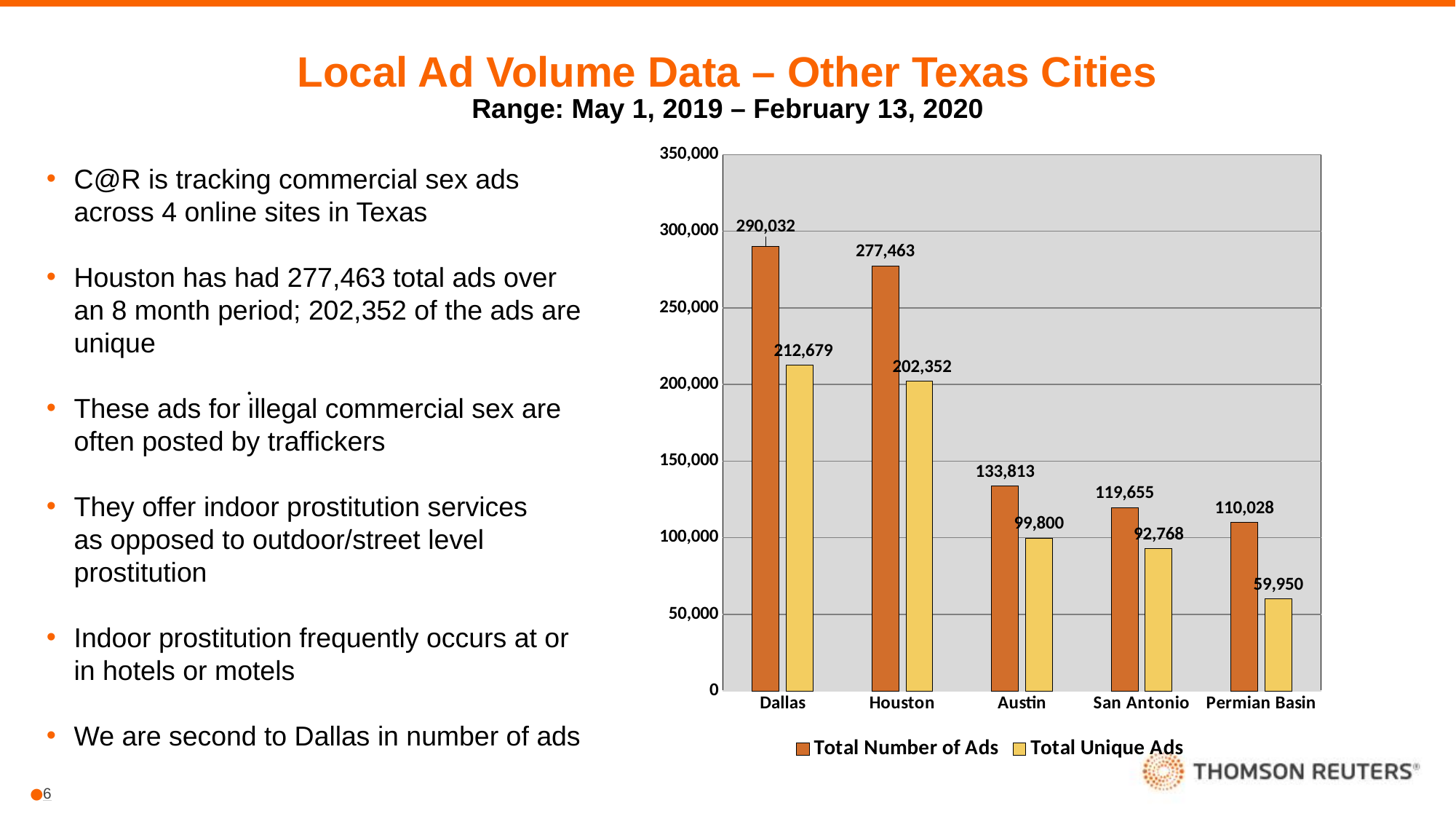
Is the Total Unique Ads value for San Antonio greater or less than 100,000? less What is the difference between Total Number of Ads and Total Unique Ads for Austin? 34,013 Which city has the highest Total Number of Ads? Dallas Which city has the lowest Total Unique Ads? Permian Basin What is the Total Unique Ads value for Permian Basin? 59,950 What is the Total Number of Ads for Dallas? 290,032 How many series does the chart legend list? 2 Which is larger: Total Number of Ads for San Antonio or Total Number of Ads for Permian Basin? San Antonio What is the date range shown in the slide subtitle? May 1, 2019 – February 13, 2020 What kind of chart is shown on the slide? Bar chart What is the Total Unique Ads value for Houston? 202,352 How many cities are shown on the x axis of the chart? 5